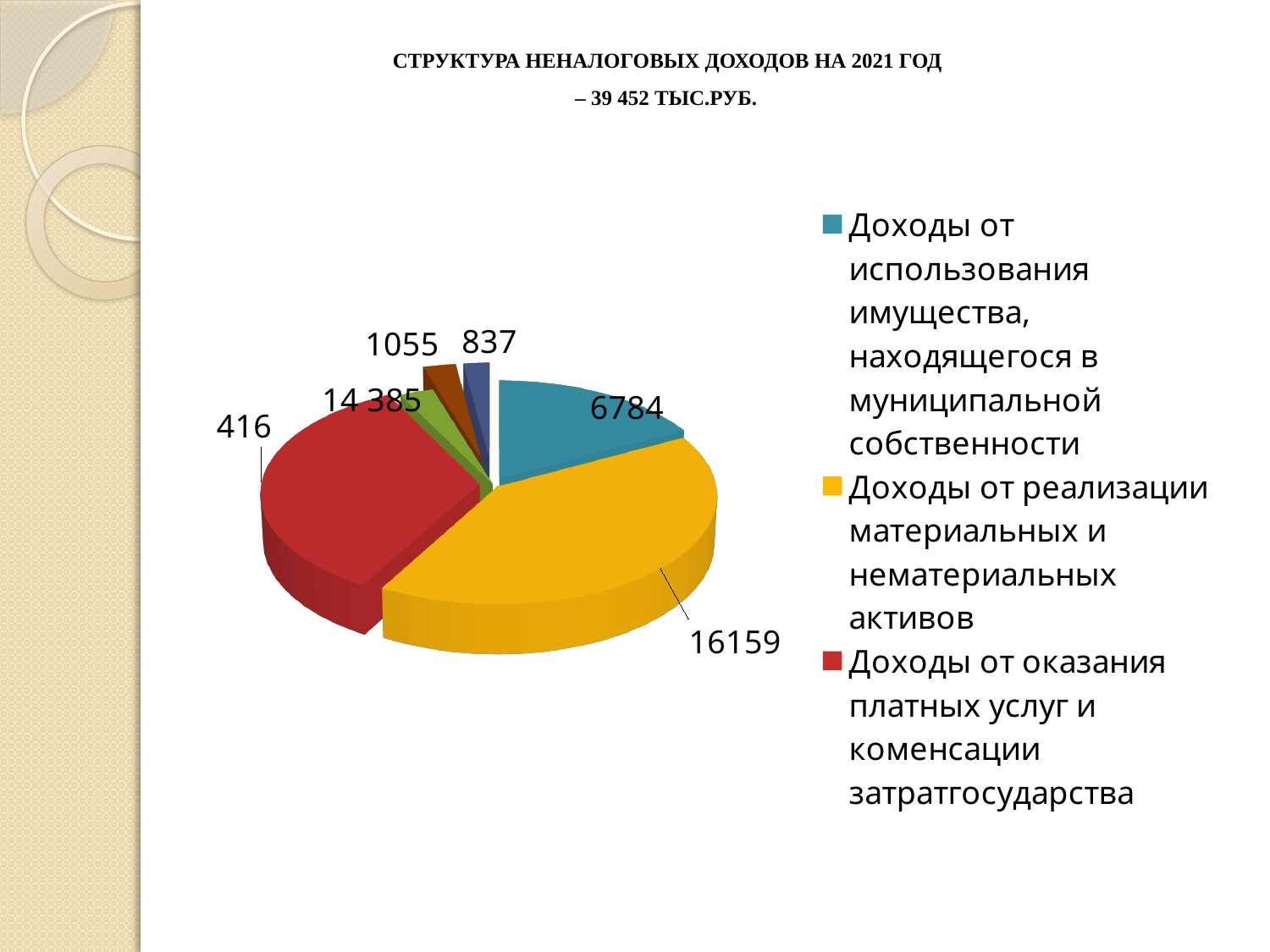
What type of chart is shown on the slide? Pie chart Which category has the largest slice of the pie? Доходы от реализации материальных и нематериальных активов What is the smallest value printed on the pie chart? 416 How many slices does the pie chart have? 6 What is the value for 'Доходы от использования имущества, находящегося в муниципальной собственности'? 6784 What is the value for 'Доходы от реализации материальных и нематериальных активов'? 16159 What colour is the slice for 'Доходы от оказания платных услуг и коменсации затратгосударства'? Red Which is larger: 'Доходы от использования имущества, находящегося в муниципальной собственности' or 'Доходы от реализации материальных и нематериальных активов'? Доходы от реализации материальных и нематериальных активов What total amount is stated in the chart title? 39 452 тыс.руб. Which is larger: 'Доходы от оказания платных услуг и коменсации затратгосударства' or 'Доходы от использования имущества, находящегося в муниципальной собственности'? Доходы от оказания платных услуг и коменсации затратгосударства What is the difference between the values for 'Доходы от реализации материальных и нематериальных активов' and 'Доходы от использования имущества, находящегося в муниципальной собственности'? 9375 How many entries does the legend list? 3